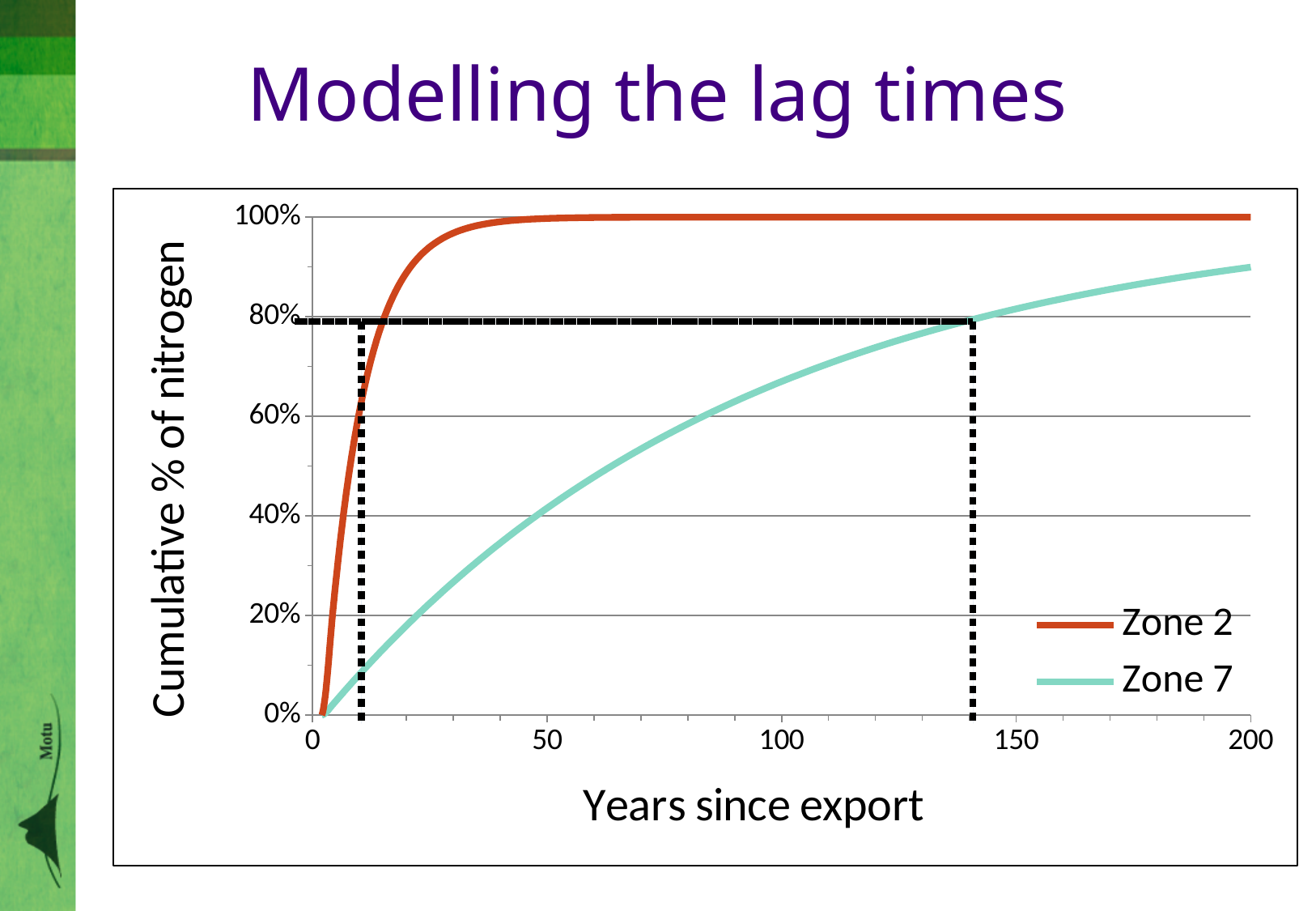
Is the value for Zone 2 at 50 years since export greater or less than 80%? greater Is the value for Zone 7 at 100 years since export greater or less than 80%? less How many series does the legend list? 2 What kind of chart is shown on the slide? line chart At 100 years since export, which series has the higher cumulative % of nitrogen, Zone 2 or Zone 7? Zone 2 Does the Zone 2 line rise or fall as years since export increase? rise What are the two series named in the legend? Zone 2 and Zone 7 Is the value for Zone 7 at 100 years since export greater or less than 60%? greater What is the title of the slide containing the chart? Modelling the lag times Does the Zone 7 line rise or fall as years since export increase? rise Which series reaches 80% cumulative nitrogen sooner, Zone 2 or Zone 7? Zone 2